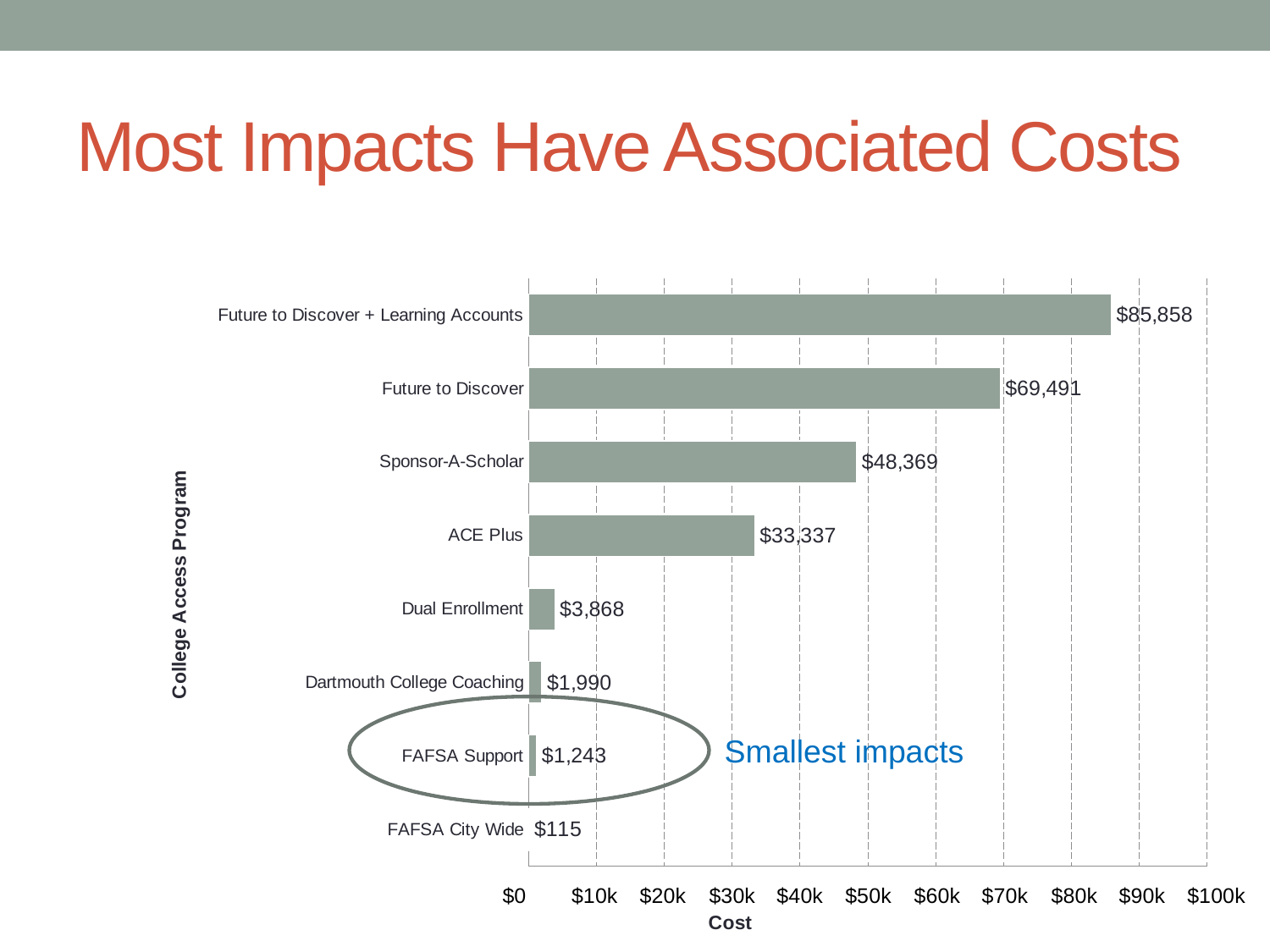
What is the cost for Dual Enrollment? $3,868 Which college access program has the highest cost? Future to Discover + Learning Accounts What is the difference in cost between Future to Discover + Learning Accounts and Future to Discover? $16,367 Which has a higher cost, ACE Plus or Sponsor-A-Scholar? Sponsor-A-Scholar Is the cost for Future to Discover greater or less than $60k? greater What kind of chart is shown on the slide? Bar chart What is the cost for FAFSA City Wide? $115 Which college access program has the lowest cost? FAFSA City Wide How many college access programs are shown in the chart? 8 What is the difference in cost between Dartmouth College Coaching and FAFSA Support? $747 What is the cost for Sponsor-A-Scholar? $48,369 What is the label of the horizontal axis of the chart? Cost